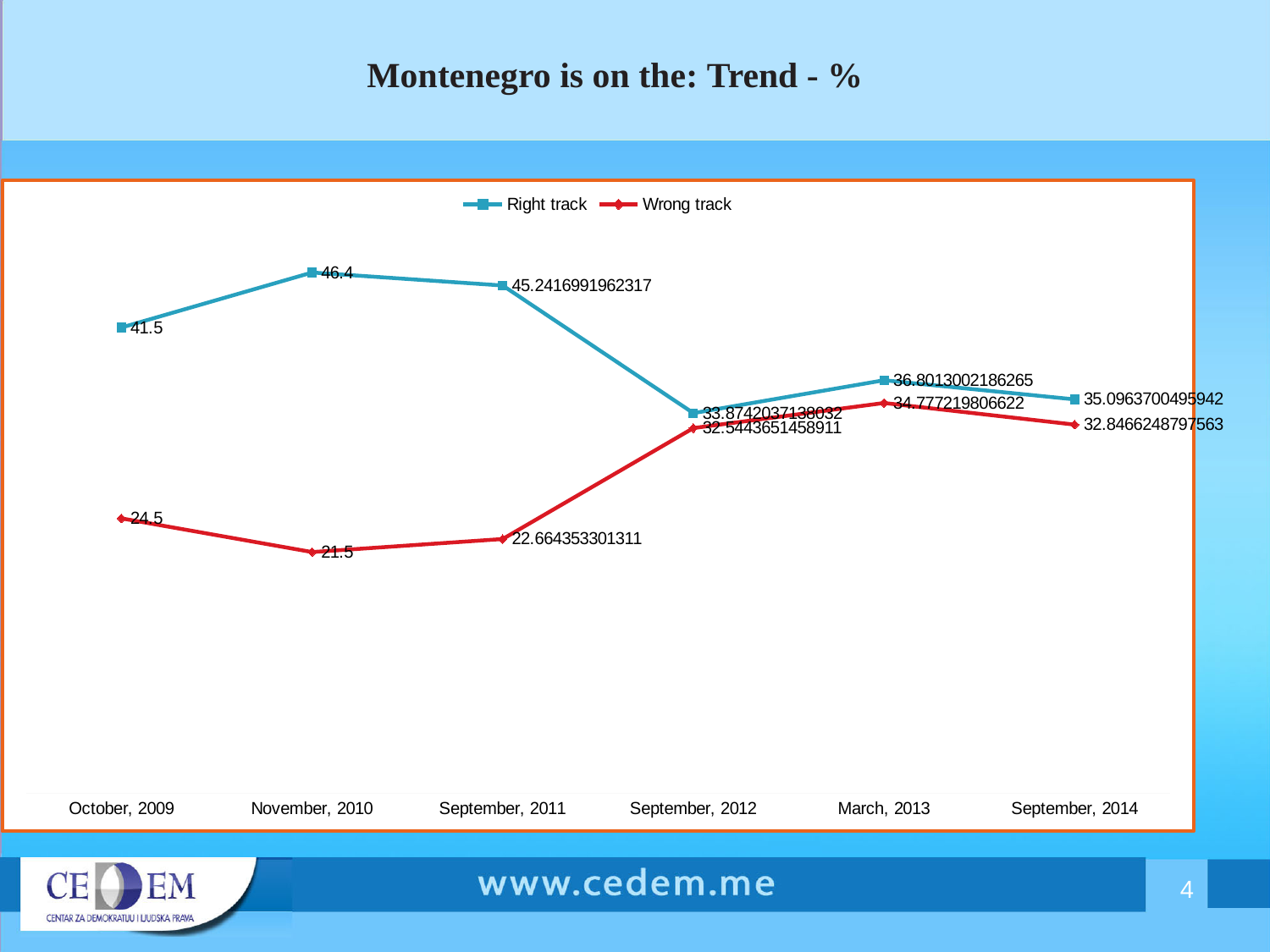
What is the Right track value for September, 2011? 45.2416991962317 At which time point is the Right track value highest? November, 2010 Does the Wrong track line rise or fall from September, 2011 to March, 2013? Rise In September, 2014, which series has the larger value, Right track or Wrong track? Right track At which time point is the Wrong track value lowest? November, 2010 What is the difference between the Right track values for November, 2010 and October, 2009? 4.9 What is the Wrong track value for October, 2009? 24.5 How many series does the legend list? 2 What is the Right track value for November, 2010? 46.4 How many time points are shown on the x axis? 6 What is the Wrong track value for November, 2010? 21.5 What kind of chart is shown on the slide? Line chart